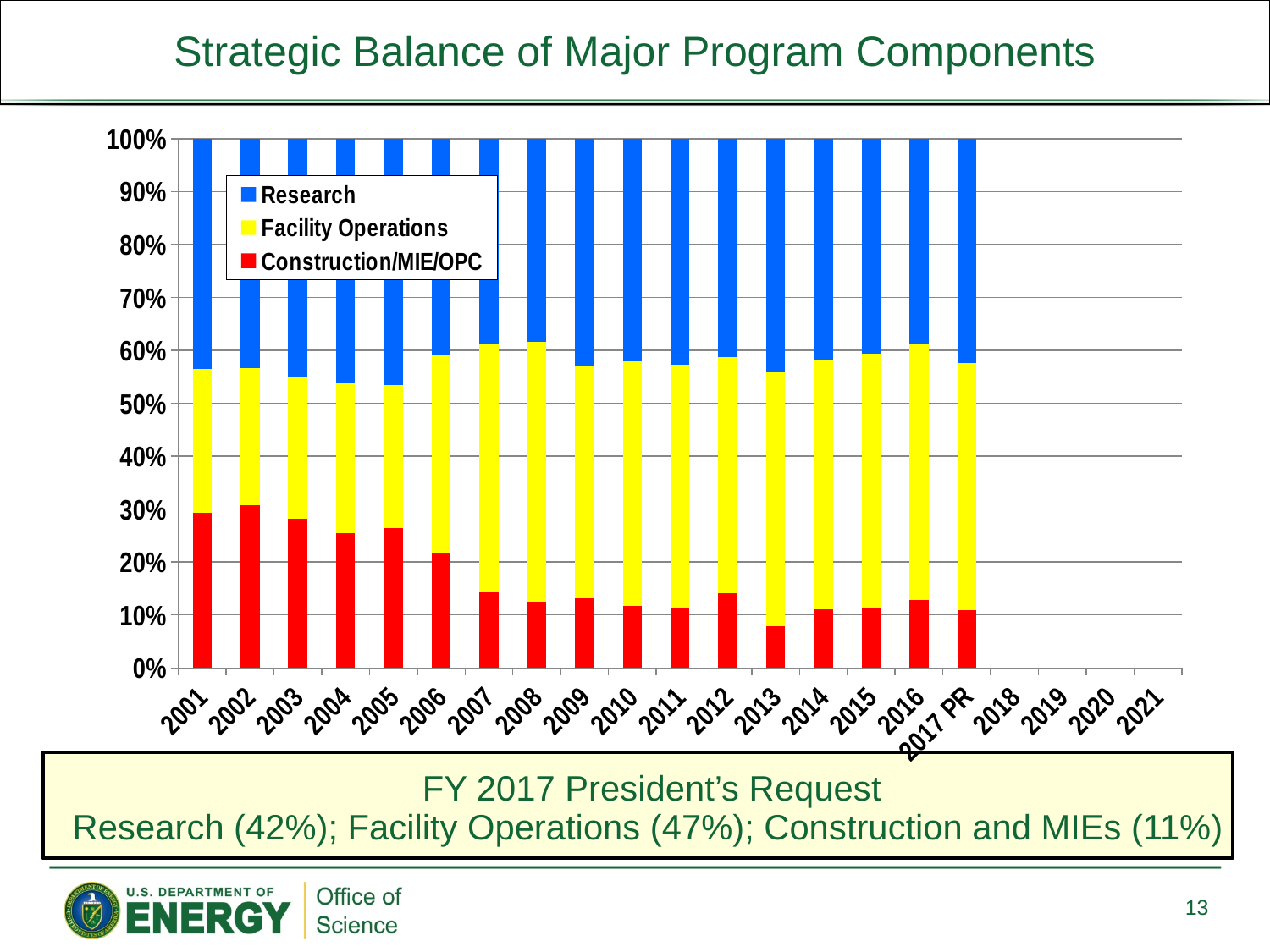
Which colour represents Research in the chart? blue Which year has the lowest Construction/MIE/OPC share? 2013 What kind of chart is shown on the slide? stacked bar chart According to the slide, what share of the FY 2017 President's Request is Construction and MIEs? 11% Is the Construction/MIE/OPC share for 2001 greater or less than 20%? greater In the FY 2017 President's Request, how many percentage points larger is Facility Operations than Research? 5% Is the Construction/MIE/OPC share for 2013 greater or less than 10%? less According to the slide, what share of the FY 2017 President's Request is Research? 42% How many series does the chart legend list? 3 How many years have bars plotted in the chart? 17 According to the slide, what share of the FY 2017 President's Request is Facility Operations? 47% Which year has the larger Construction/MIE/OPC share, 2002 or 2013? 2002